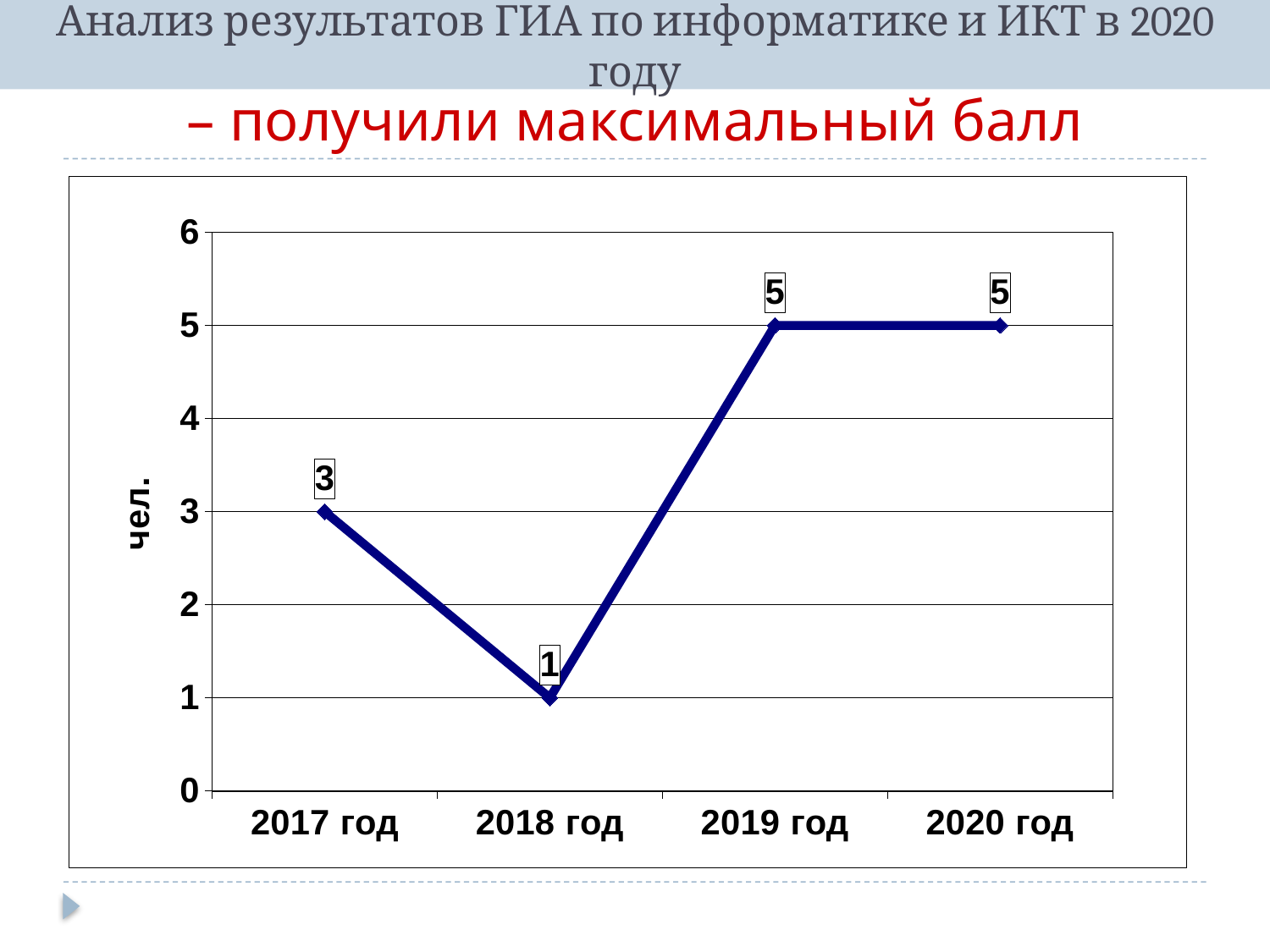
What is the value for 2018 год? 1 What is the difference between the values for 2017 год and 2018 год? 2 What is the difference between the values for 2019 год and 2018 год? 4 How many years are plotted on the chart? 4 What is the value for 2019 год? 5 What is the value for 2017 год? 3 Is the value for 2019 год greater or less than 4? greater Which year has the lowest value? 2018 год What is the label of the vertical axis? чел. What kind of chart is shown on the slide? line chart What is the value for 2020 год? 5 Which is larger, the value for 2017 год or the value for 2018 год? 2017 год